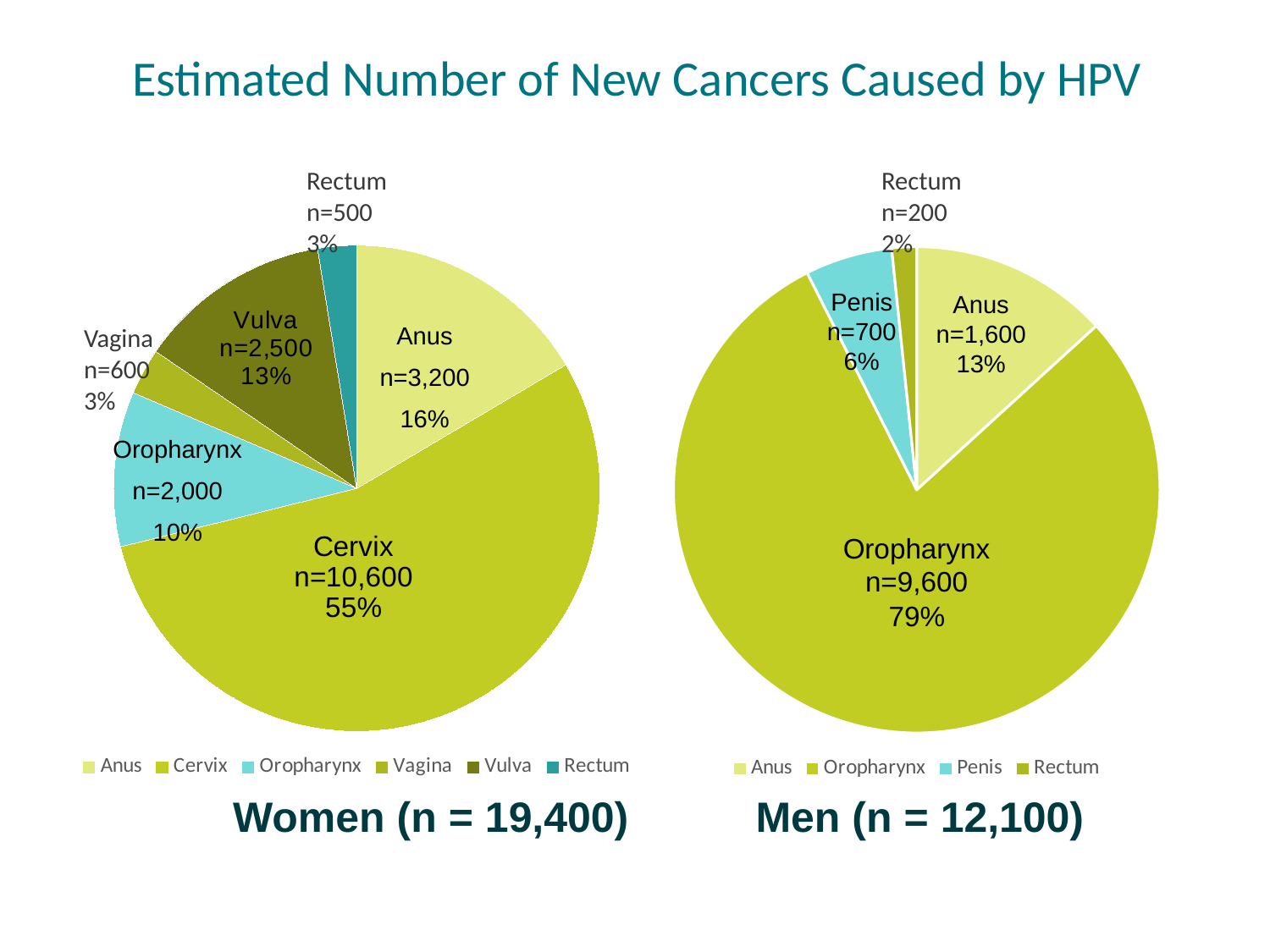
In the Men pie chart, which category has the smallest slice? Rectum How many categories does the Women pie chart legend list? 6 In the Women pie chart, which category has the largest slice? Cervix What is the total number of new cancers shown for the Men chart? 12,100 In the Men pie chart, what percentage share does Oropharynx have? 79% In the Men pie chart, which is larger, Anus or Penis? Anus How many categories does the Men pie chart legend list? 4 In the Women pie chart, what is the difference between the Anus and Vulva counts? 700 In the Women pie chart, what is the number of new cancers for Cervix? n=10,600 What type of chart is used on this slide? Pie chart In the Men pie chart, what is the number of new cancers for Penis? n=700 In the Women pie chart, what percentage share does Oropharynx have? 10%